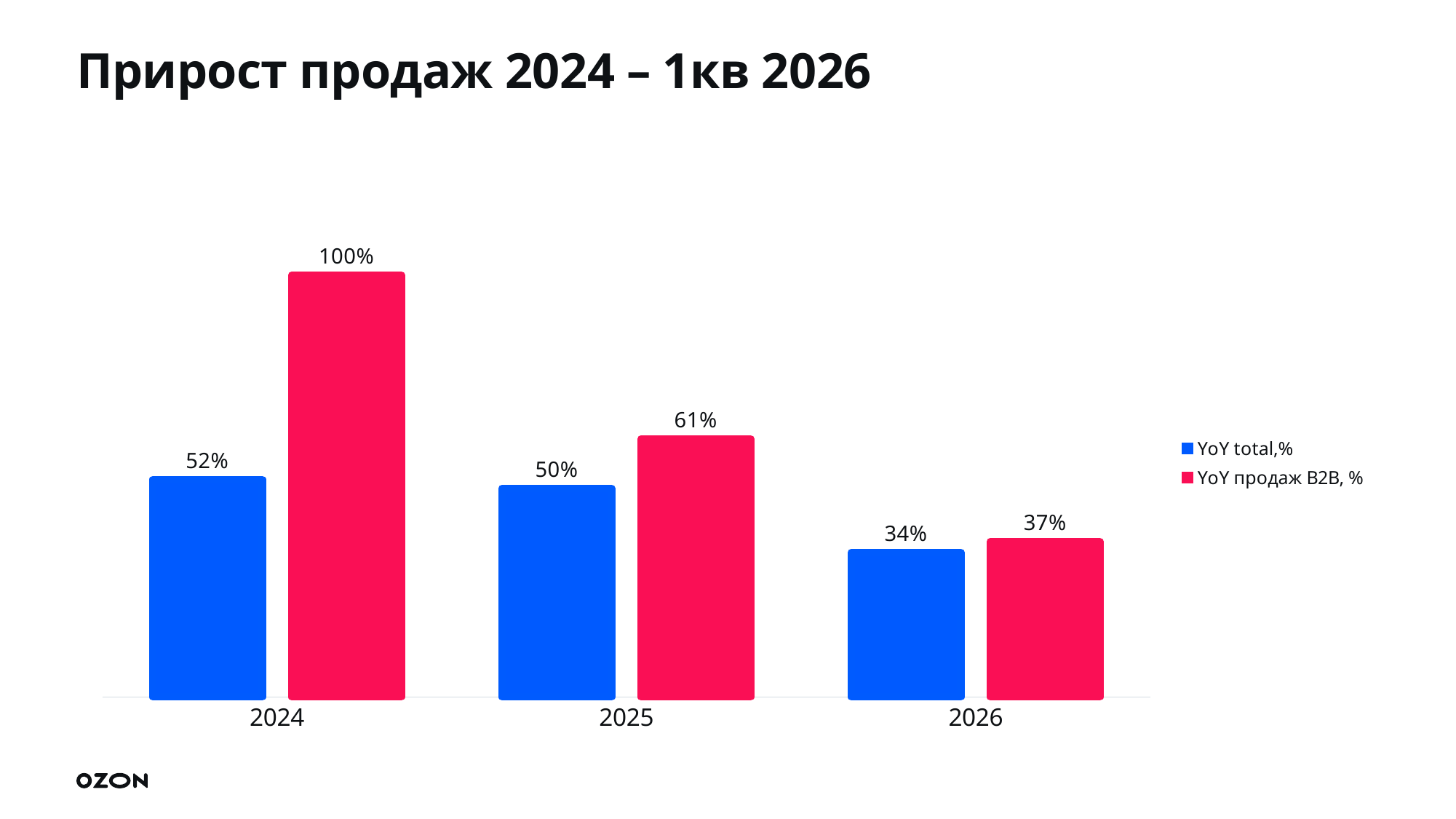
Do the values for YoY продаж B2B, % rise or fall from 2024 to 2026? Fall What is the difference between YoY продаж B2B, % in 2025 and in 2026? 24% What kind of chart is shown on the slide? Bar chart What is the difference between YoY продаж B2B, % and YoY total,% in 2024? 48% What is the value of YoY продаж B2B, % for 2025? 61% Which is larger in 2026: YoY total,% or YoY продаж B2B, %? YoY продаж B2B, % How many series does the legend list? 2 How many years are shown on the x axis? 3 Which year has the highest value for YoY продаж B2B, %? 2024 Which year has the lowest value for YoY total,%? 2026 What is the value of YoY total,% for 2024? 52% What is the value of YoY total,% for 2026? 34%